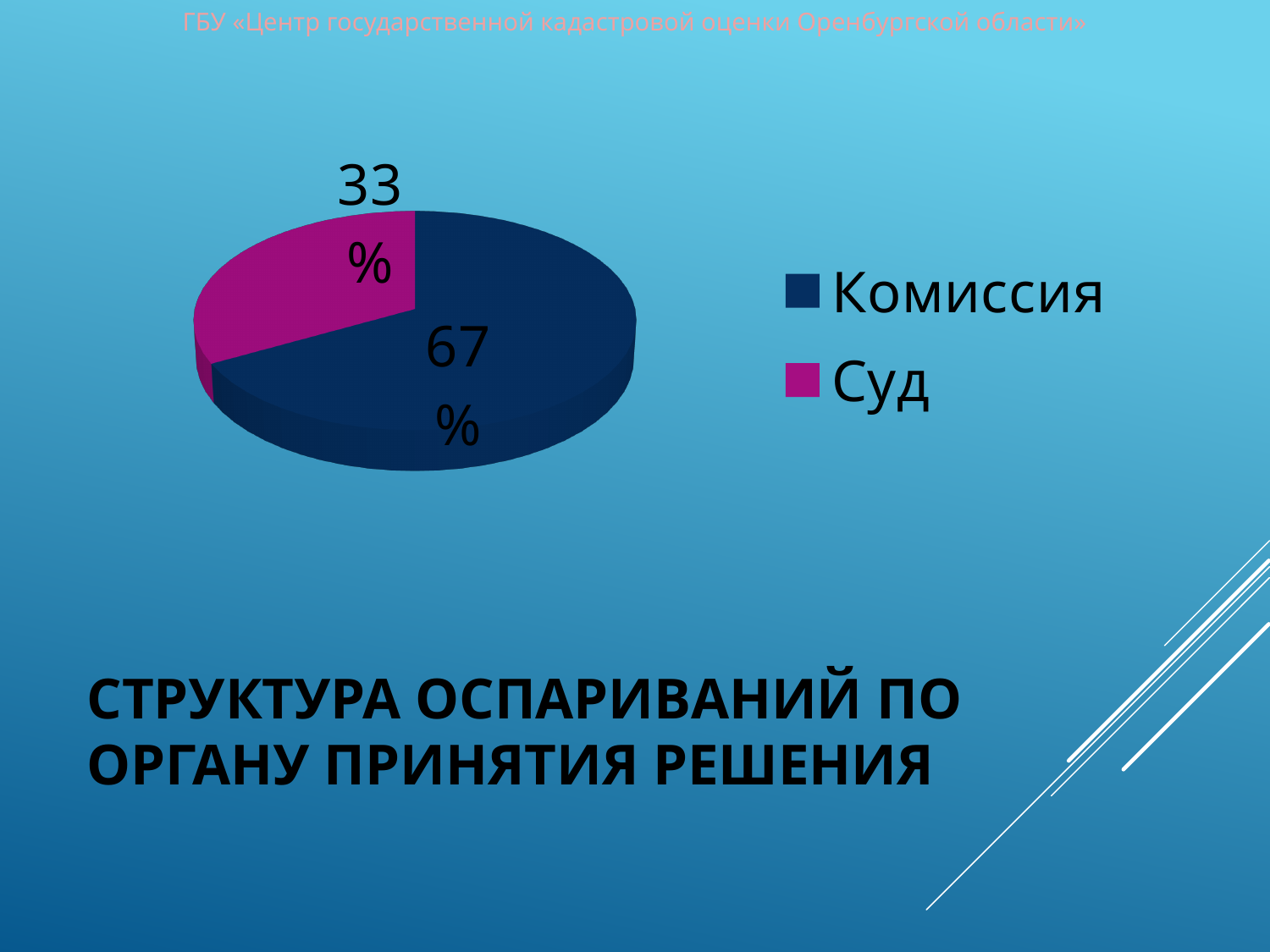
How many entries does the legend list? 2 Which category has the smallest slice of the pie? Суд Which category has the largest slice of the pie? Комиссия What kind of chart is shown on the slide? Pie chart What share of the pie does Комиссия account for? 67% Which slice is larger, Комиссия or Суд? Комиссия What share of the pie does Суд account for? 33% What is the title text shown below the chart? СТРУКТУРА ОСПАРИВАНИЙ ПО ОРГАНУ ПРИНЯТИЯ РЕШЕНИЯ Is the share for Суд greater or less than 50%? less What is the difference in percentage points between the Комиссия and Суд slices? 34 How many slices does the pie chart have? 2 What colour is the Суд slice in the pie chart? Magenta